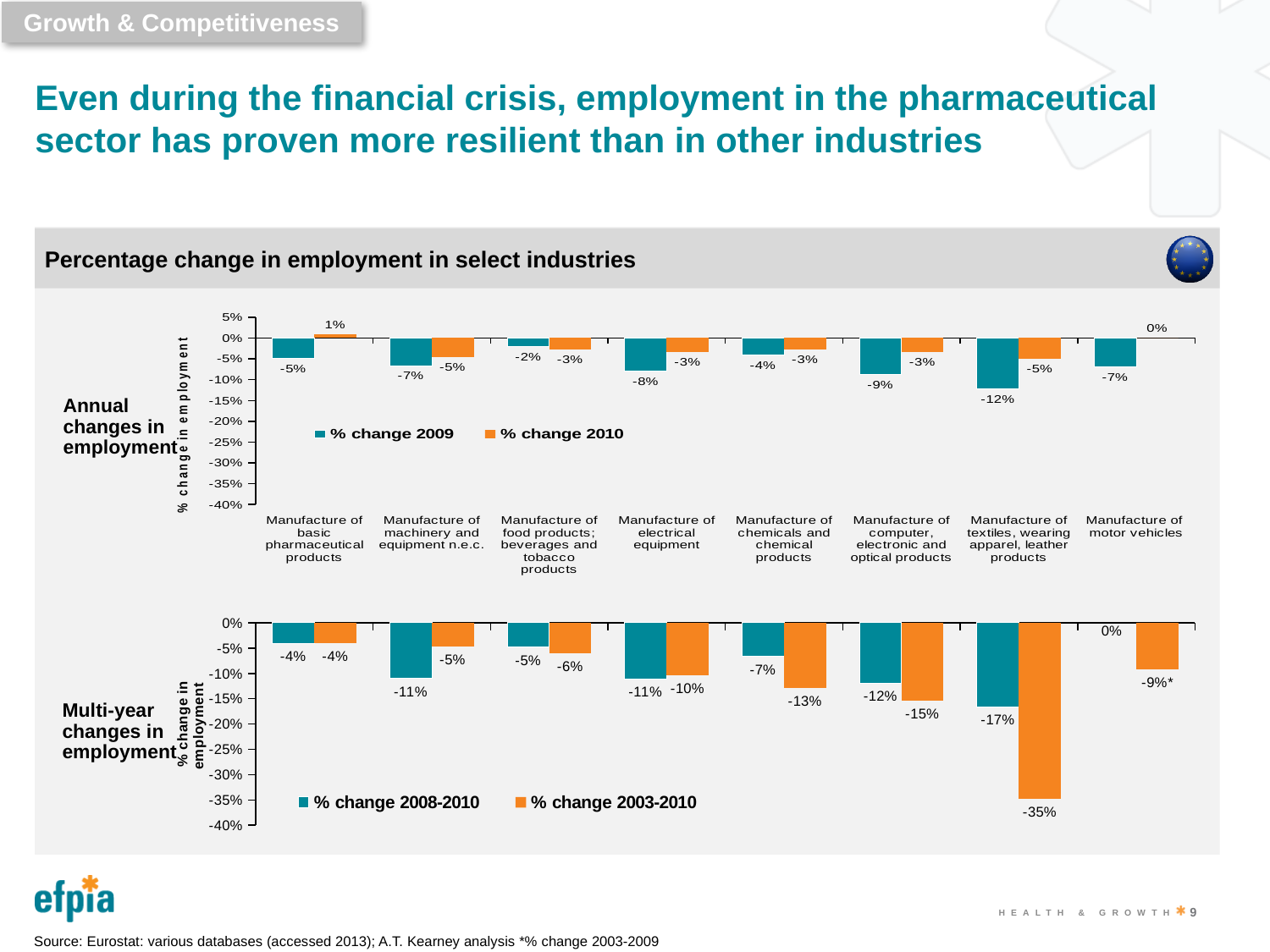
In the top chart (Annual changes in employment), what is the % change 2010 for Manufacture of basic pharmaceutical products? 1% In the bottom chart (Multi-year changes in employment), what is the difference between the % change 2003-2010 for Manufacture of computer, electronic and optical products and for Manufacture of basic pharmaceutical products? 11 percentage points In the bottom chart (Multi-year changes in employment), what is the % change 2003-2010 for Manufacture of textiles, wearing apparel, leather products? -35% In the top chart (Annual changes in employment), what is the difference between the % change 2009 for Manufacture of electrical equipment and for Manufacture of basic pharmaceutical products? 3 percentage points In the top chart (Annual changes in employment), which industry has the lowest % change 2009? Manufacture of textiles, wearing apparel, leather products How many industries are shown on the x axis of the top chart (Annual changes in employment)? 8 How many series does the legend of the bottom chart (Multi-year changes in employment) list? 2 In the bottom chart (Multi-year changes in employment), which is larger: the % change 2008-2010 for Manufacture of chemicals and chemical products or the % change 2003-2010 for the same industry? % change 2008-2010 What type of chart is the top chart (Annual changes in employment)? Bar chart In the top chart (Annual changes in employment), what is the % change 2009 for Manufacture of textiles, wearing apparel, leather products? -12% In the bottom chart (Multi-year changes in employment), what is the % change 2008-2010 for Manufacture of motor vehicles? 0% In the top chart (Annual changes in employment), which industry has the highest % change 2010? Manufacture of basic pharmaceutical products